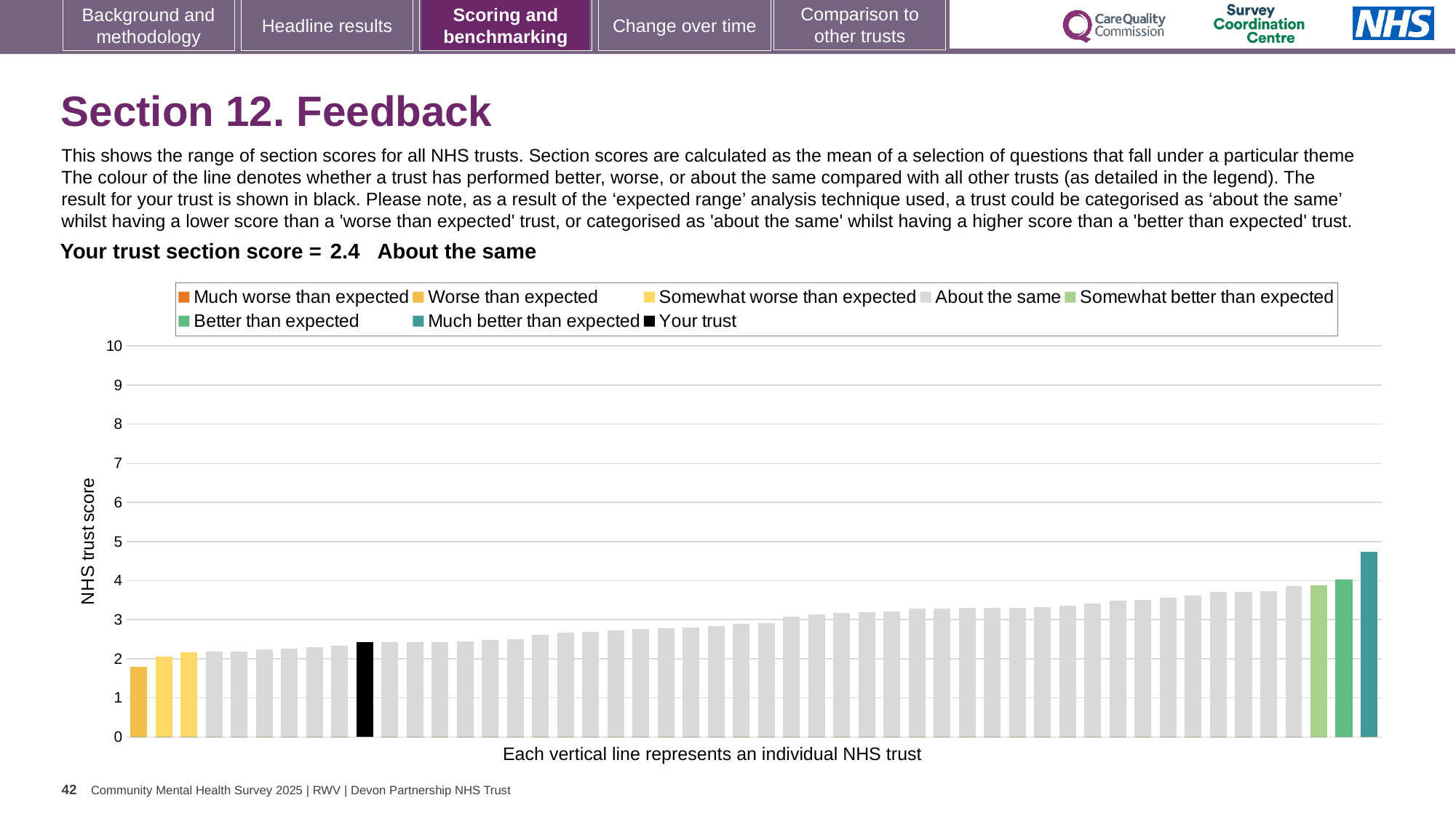
What is the title of the vertical axis? NHS trust score Do the bar values rise or fall moving from left to right along the x axis? rise What is the section score for your trust shown on the slide? 2.4 Is the value for your trust (the black bar) greater or less than 3? less Which legend category does the shortest bar on the chart belong to? Worse than expected Which category is your trust's section score placed in, according to the text above the chart? About the same Is the value of the tallest bar (the 'Much better than expected' trust) greater or less than 4? greater Which is taller: the black 'Your trust' bar or the teal 'Much better than expected' bar? the teal 'Much better than expected' bar Which legend category does the tallest bar on the chart belong to? Much better than expected How many entries does the chart legend list? 8 Is the value of the shortest bar (the leftmost trust) greater or less than 2? less What kind of chart is shown on the slide? bar chart